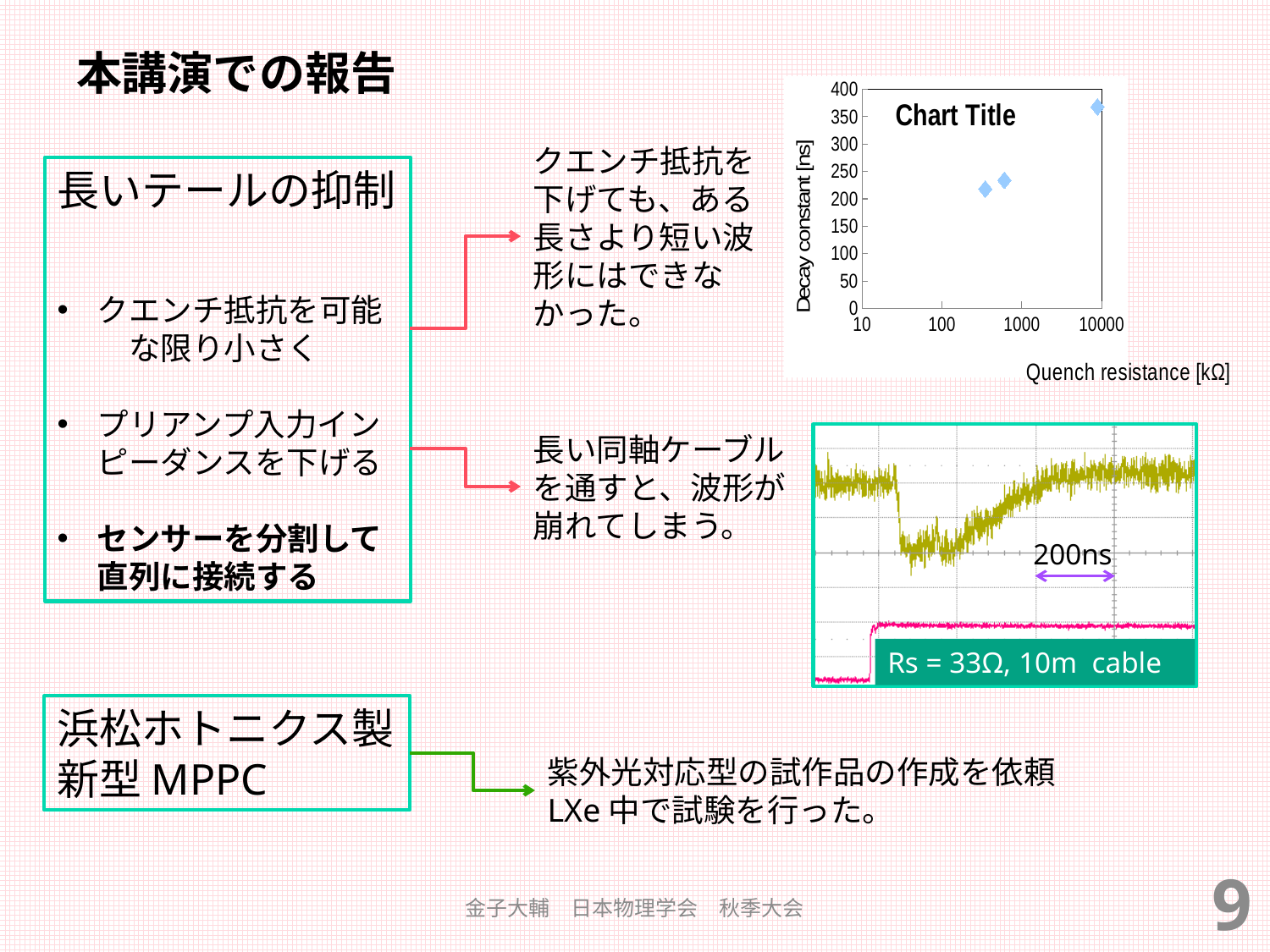
In the chart titled "Chart Title", is the decay constant of the point at the highest quench resistance greater or less than 350 ns? greater In the chart titled "Chart Title", is the decay constant of the point at the highest quench resistance greater or less than 300 ns? greater What is the x-axis label of the scatter chart in the upper right of the slide? Quench resistance [kΩ] In the chart titled "Chart Title", which has the higher decay constant: the point at the largest quench resistance or the point at the smallest quench resistance? the point at the largest quench resistance In the chart titled "Chart Title", is the decay constant of the point at the lowest quench resistance greater or less than 250 ns? less In the chart titled "Chart Title", does the decay constant rise or fall as the quench resistance increases? rise What kind of chart is the chart titled "Chart Title" in the upper right of the slide? scatter chart What is the title shown on the scatter chart in the upper right of the slide? Chart Title How many data points are plotted in the chart titled "Chart Title"? 3